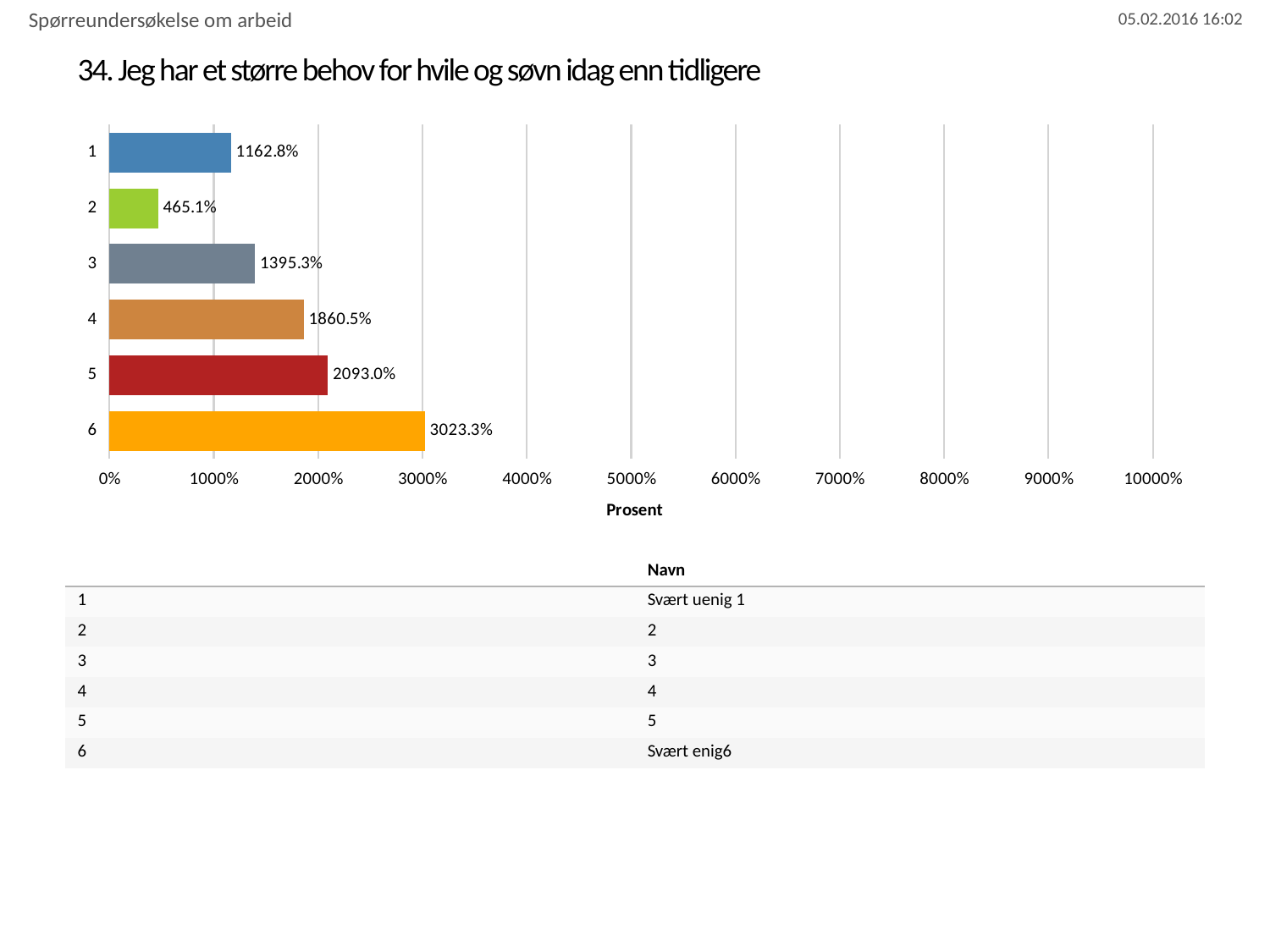
How many categories are shown in the chart? 6 Is the value for category 5 greater or less than 2000%? greater What kind of chart is shown on the slide? bar chart Which category has the lowest value? 2 What is the title of the chart? 34. Jeg har et større behov for hvile og søvn idag enn tidligere What is the label of the horizontal axis? Prosent What is the value for category 6? 3023.3% What is the value for category 4? 1860.5% Which category has the highest value? 6 Which is larger, the value for category 3 or the value for category 1? 3 What is the difference between the values for category 5 and category 4? 232.5% What is the value for category 1? 1162.8%